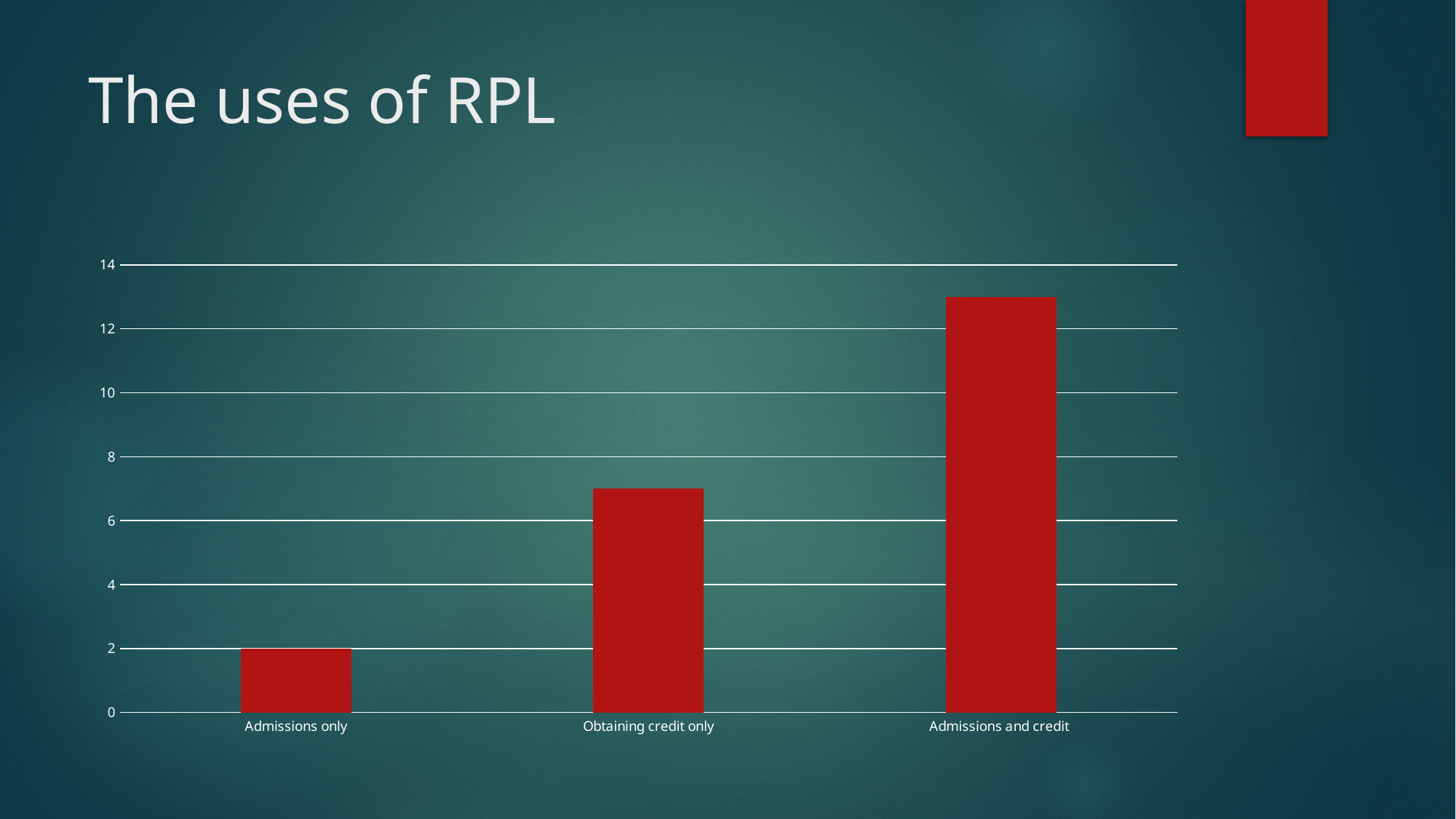
Which category has the lowest value? Admissions only Which is larger, the value for Obtaining credit only or the value for Admissions only? Obtaining credit only Is the value for Admissions and credit greater or less than 12? greater Is the value for Admissions and credit greater or less than 14? less What colour are the bars in the chart? red Is the value for Obtaining credit only greater or less than 8? less Do the values rise or fall from left to right along the x axis? rise What kind of chart is shown on the slide? bar chart Which category has the highest value? Admissions and credit How many categories are shown on the x axis? 3 What is the value for Admissions only? 2